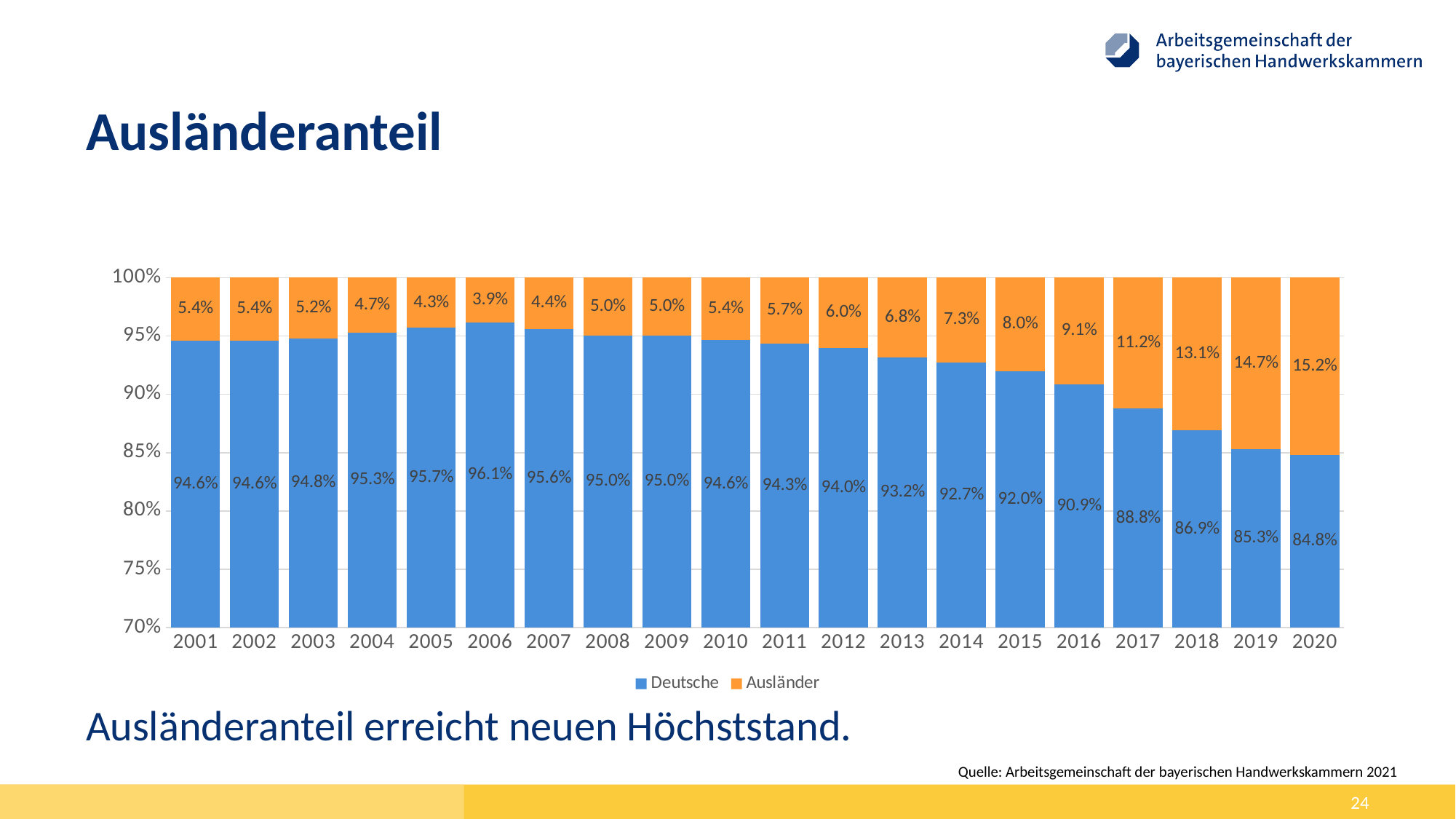
What is the difference between the Ausländer values for 2020 and 2001? 9.8% How many years are shown on the x axis? 20 Which is larger, the Ausländer value for 2017 or for 2015? 2017 What is the Deutsche value for 2006? 96.1% How many series does the legend list? 2 In which year is the Ausländer share lowest? 2006 What kind of chart is shown on the slide? Stacked bar chart In which year is the Ausländer share highest? 2020 Does the Ausländer share rise or fall from 2010 to 2020? Rise What is the Ausländer value for 2020? 15.2% What is the Ausländer value for 2013? 6.8% Which colour represents the Ausländer series? Orange